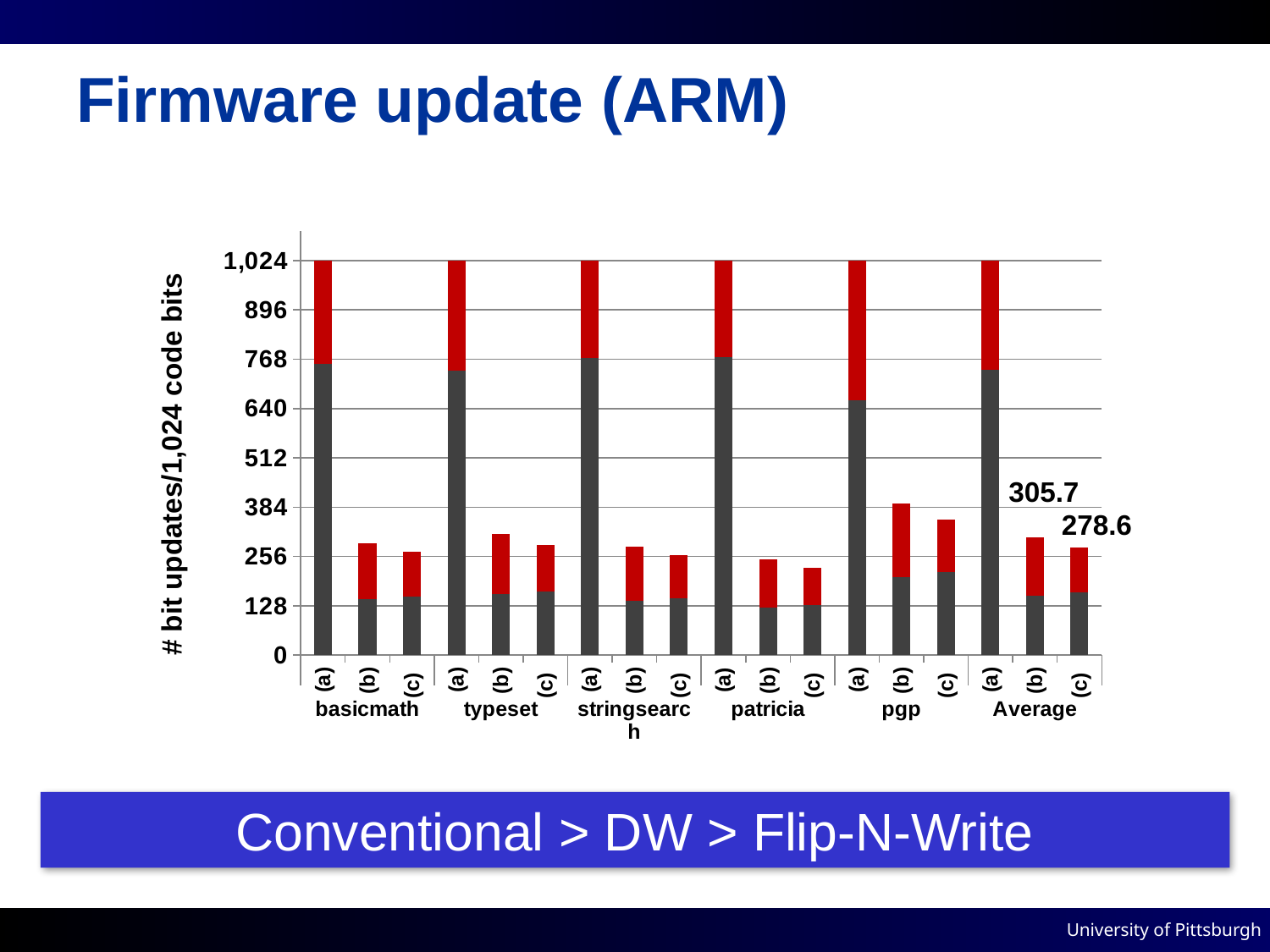
How many benchmark groups are shown along the x axis? 6 Within the pgp group, which bar is the highest? (a) What is the labelled value of the Average (c) bar? 278.6 Is the value for basicmath (b) greater or less than 384? less How many bars are shown in each benchmark group? 3 What value does the top of the basicmath (a) bar reach on the y axis? 1,024 What is the difference between the Average (b) and Average (c) values? 27.1 Which is larger, the Average (b) bar or the Average (c) bar? Average (b) What is the labelled value of the Average (b) bar? 305.7 Is the value for patricia (c) greater or less than 256? less What kind of chart is shown on the slide? bar chart What is the y-axis title of the chart? # bit updates/1,024 code bits